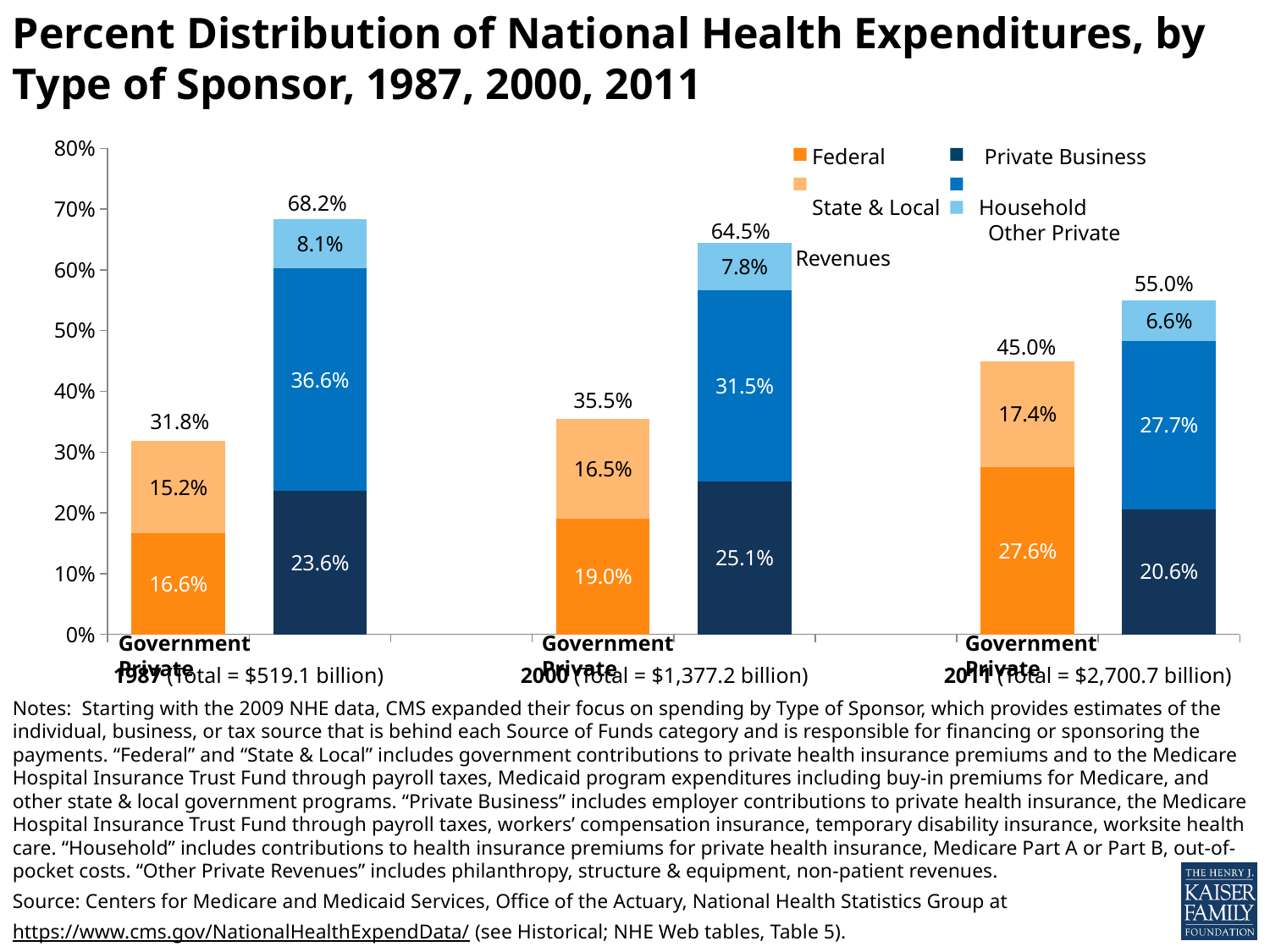
What is the Federal share of the Government bar in 1987? 16.6% Which is larger in 2011: the Federal share of the Government bar or the Private Business share of the Private bar? Federal What is the Household share of the Private bar in 2000? 31.5% What is the difference between the Private total and the Government total in 1987? 36.4% What is the total of the Government bar in 2000? 35.5% What is the State & Local share of the Government bar in 2011? 17.4% How many series does the legend list? 5 Which year has the lowest Private total? 2011 Does the Household share of the Private bar rise or fall from 1987 to 2011? Fall Which year has the highest Government total? 2011 What kind of chart is shown on the slide? Stacked bar chart What is the total of the Private bar in 2011? 55.0%